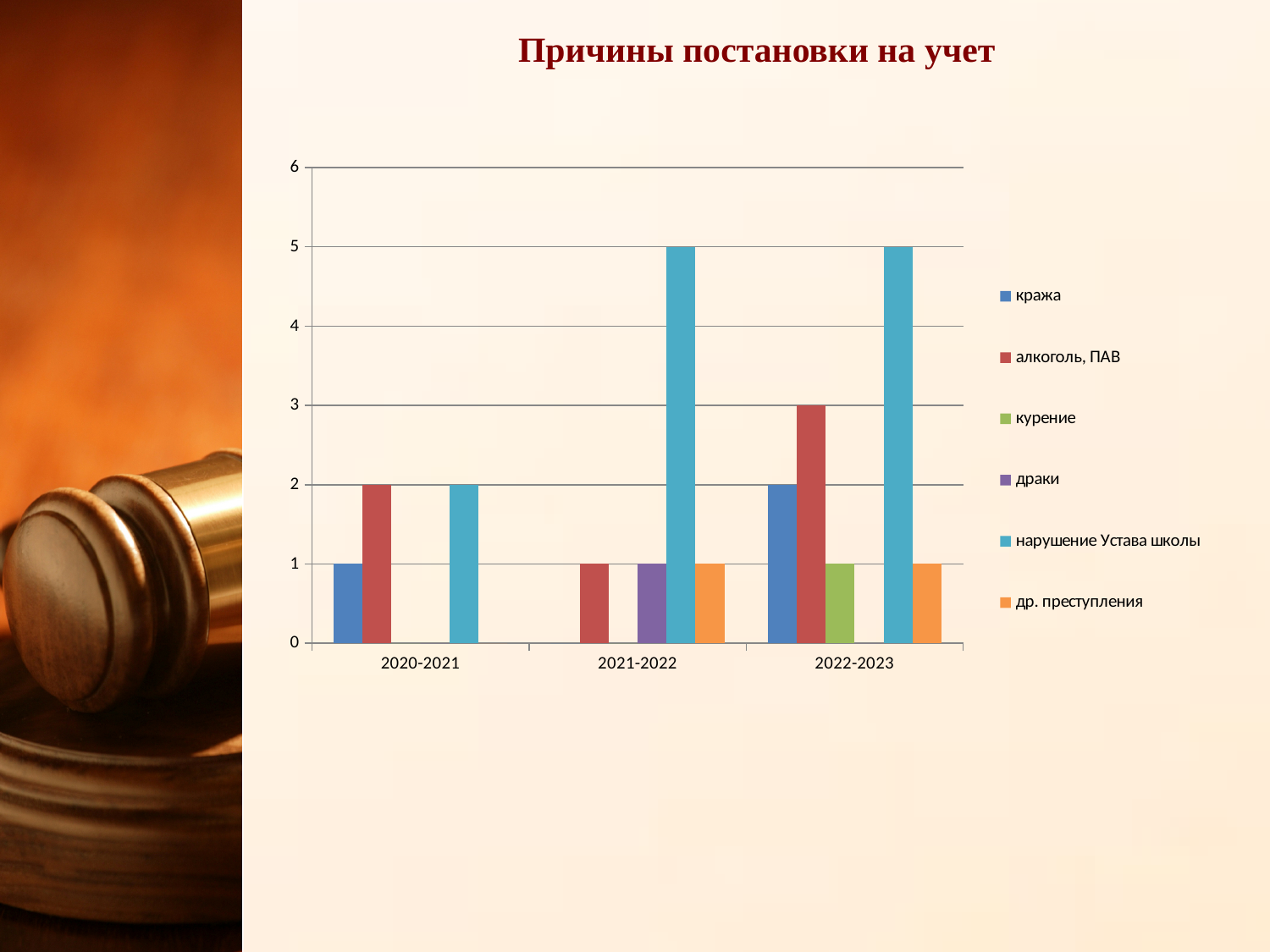
What is the title of the chart? Причины постановки на учет How many series does the legend list? 6 What is the value for нарушение Устава школы in 2021-2022? 5 What is the value for драки in 2021-2022? 1 What is the value for кража in 2020-2021? 1 Does the value for кража rise or fall from 2020-2021 to 2022-2023? rise Which series has the highest value in 2022-2023? нарушение Устава школы How many categories are shown on the x axis? 3 What is the value for алкоголь, ПАВ in 2022-2023? 3 What kind of chart is shown on the slide? bar chart Which is larger in 2020-2021: кража or алкоголь, ПАВ? алкоголь, ПАВ What is the difference between нарушение Устава школы and алкоголь, ПАВ in 2021-2022? 4